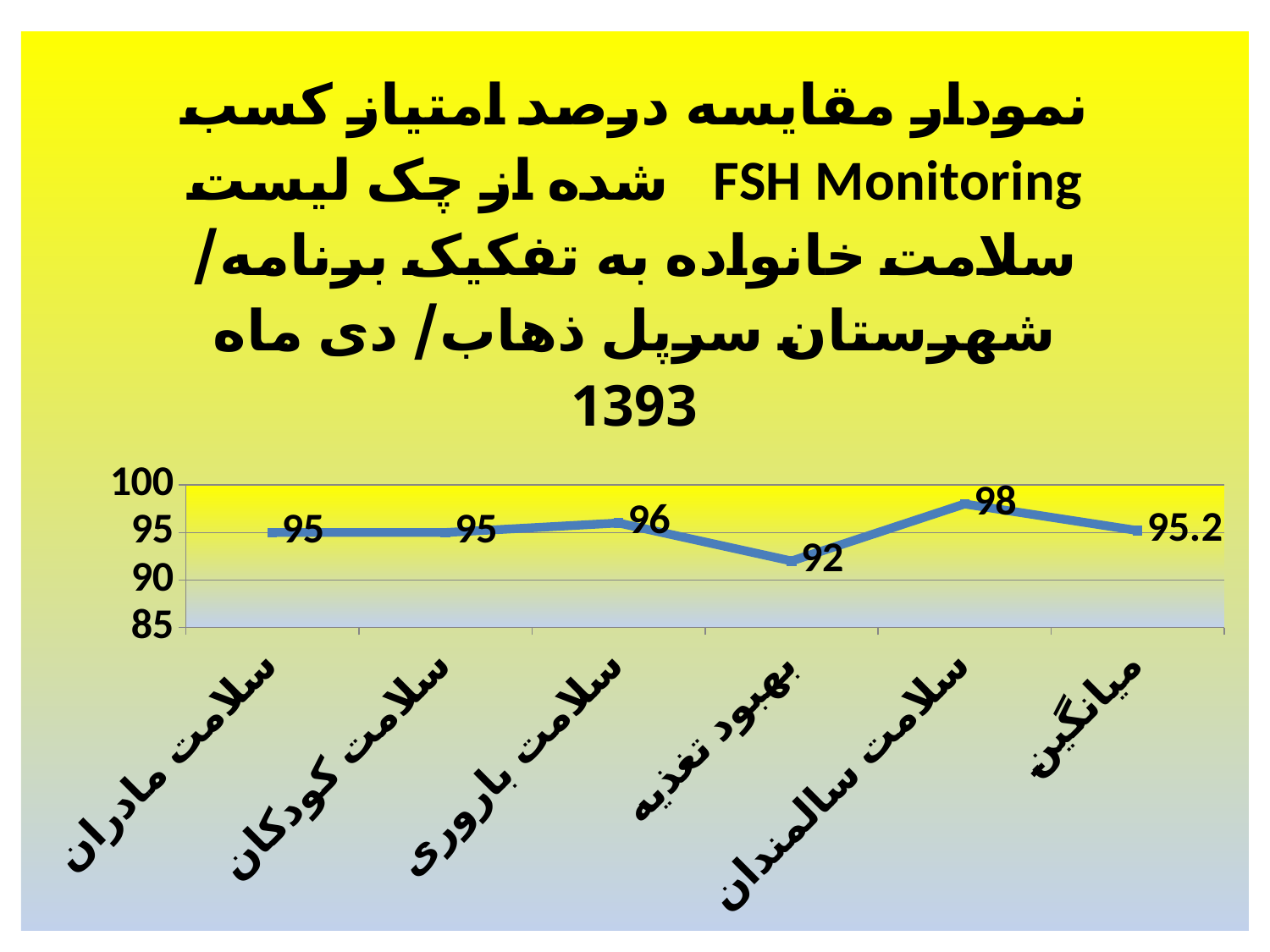
What is the difference between the values for سلامت سالمندان and بهبود تغذیه? 6 What is the value for بهبود تغذیه? 92 How many categories are plotted on the x axis? 6 What is the value for میانگین? 95.2 What is the lowest value shown on the vertical axis? 85 Which category has the highest value? سلامت سالمندان What is the value for سلامت مادران? 95 Which is larger, the value for سلامت باروری or the value for بهبود تغذیه? سلامت باروری Is the value for سلامت سالمندان greater or less than 95? greater What is the value for سلامت سالمندان? 98 Which category has the lowest value? بهبود تغذیه What kind of chart is shown on the slide? line chart